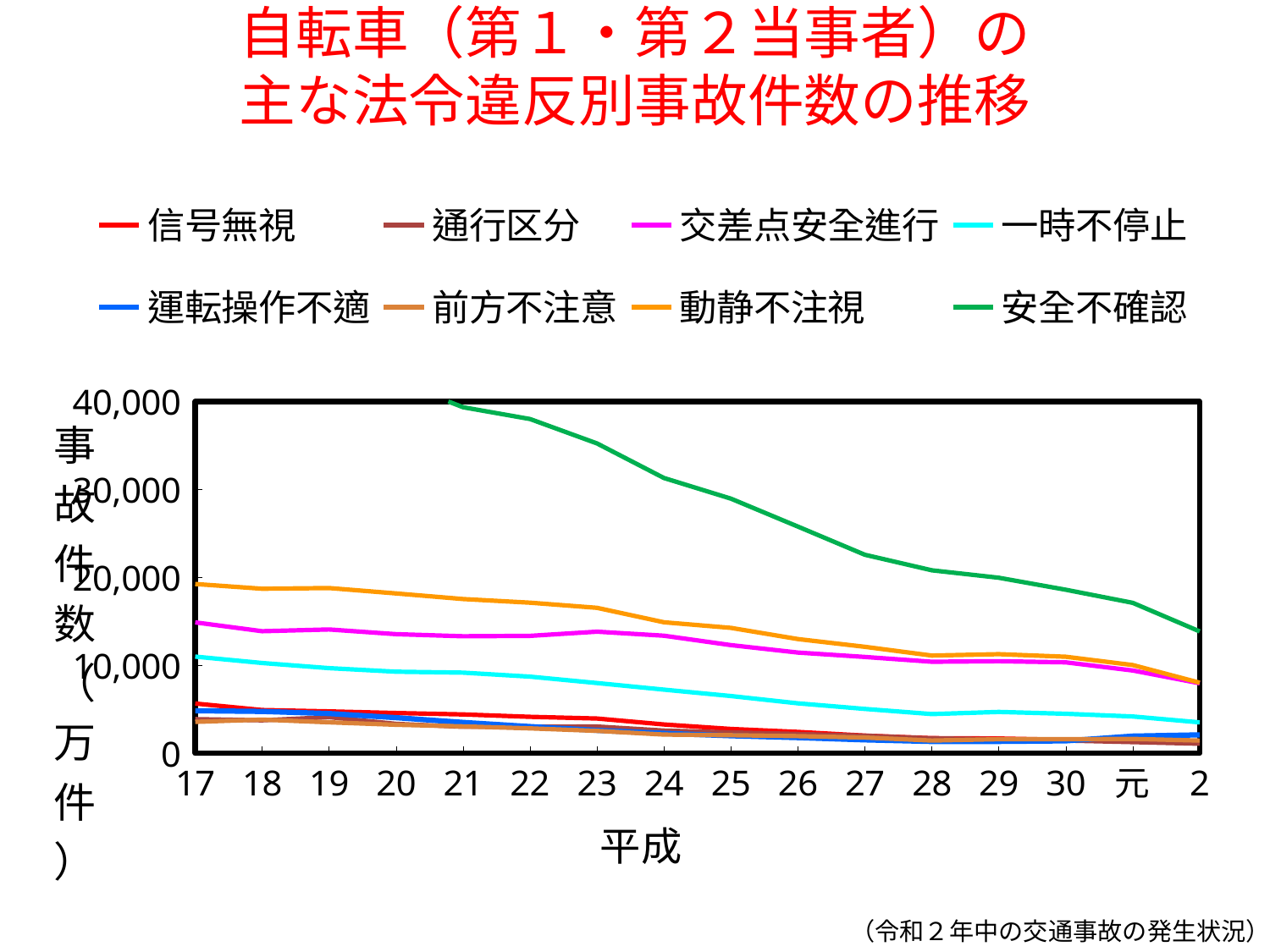
How many series does the legend list? 8 At 25, which is larger: 安全不確認 or 動静不注視? 安全不確認 Does the 動静不注視 line rise or fall from 17 to 2 along the x axis? fall Is the value for 一時不停止 at 2 greater or less than 10,000? less How many year labels are shown along the x axis? 16 What kind of chart is shown on the slide? line chart Which series has the highest values across the chart? 安全不確認 What colour is the 安全不確認 line in the legend? green Is the value for 安全不確認 at 2 greater or less than 20,000? less Is the value for 交差点安全進行 at 17 greater or less than 10,000? greater Does the 安全不確認 line rise or fall from 21 to 2 along the x axis? fall